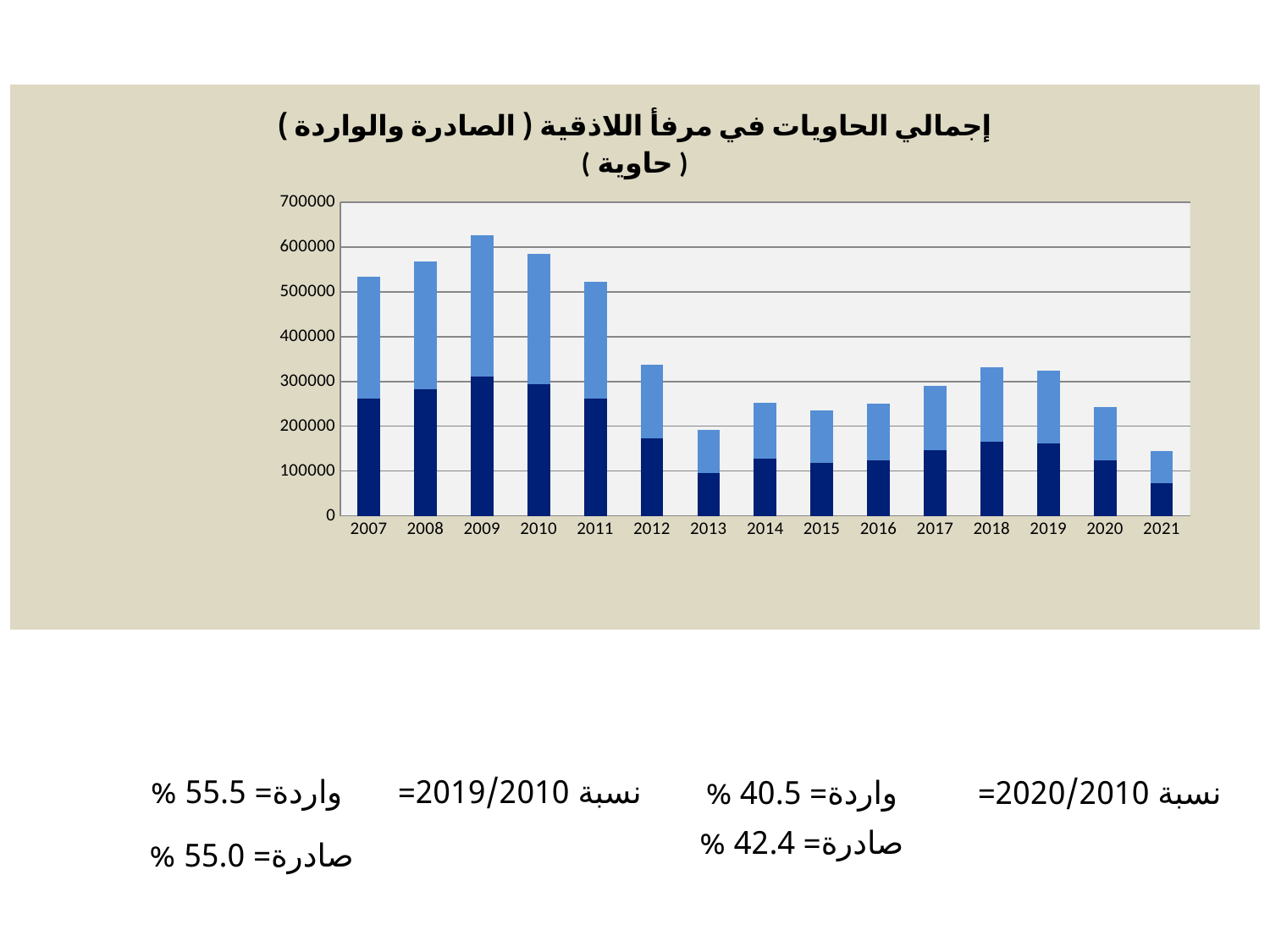
Which year has the highest total bar in the chart? 2009 Is the total value for 2013 greater or less than 200000? less How many years are shown on the x axis of the chart? 15 Which year has a larger total bar, 2012 or 2013? 2012 What kind of chart is shown on the slide? stacked bar chart Is the total value for 2020 greater or less than 300000? less Which year has a larger total bar, 2011 or 2012? 2011 Which year has the lowest total bar in the chart? 2021 Is the total value for 2007 greater or less than 500000? greater What is the first year shown on the x axis of the chart? 2007 Do the total bar values rise or fall from 2009 to 2013? fall